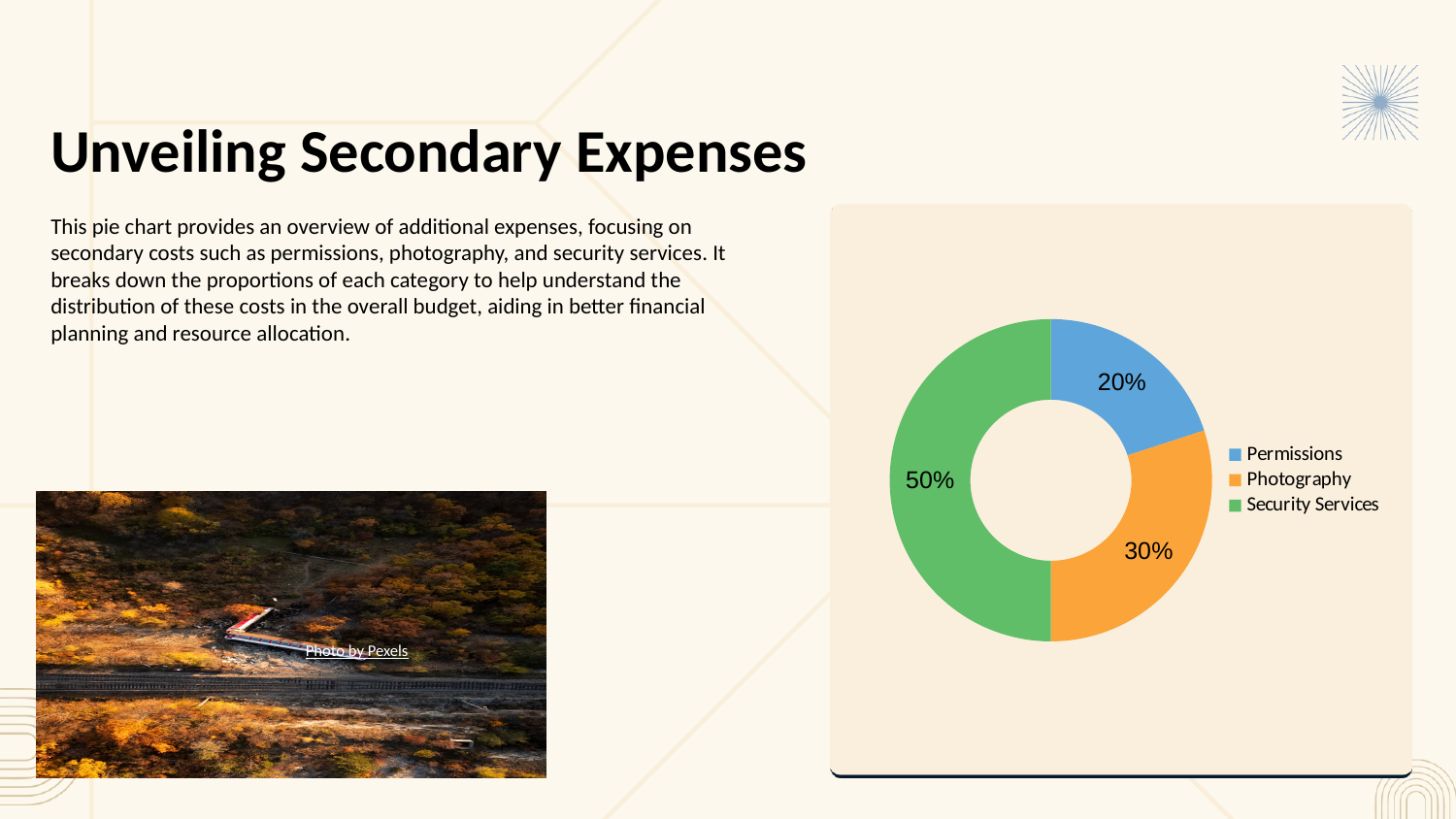
What is the difference in percentage points between Photography and Permissions? 10 What share of the pie does Photography represent? 30% Which category has the smallest share of the pie? Permissions What share of the pie does Security Services represent? 50% What is the difference in percentage points between Security Services and Photography? 20 How many categories are shown in the pie chart? 3 What colour is the Security Services slice? Green Which category is shown in orange in the legend? Photography What kind of chart is shown on the slide? Doughnut chart Which is larger, the share for Photography or the share for Permissions? Photography What share of the pie does Permissions represent? 20% Which category has the largest share of the pie? Security Services